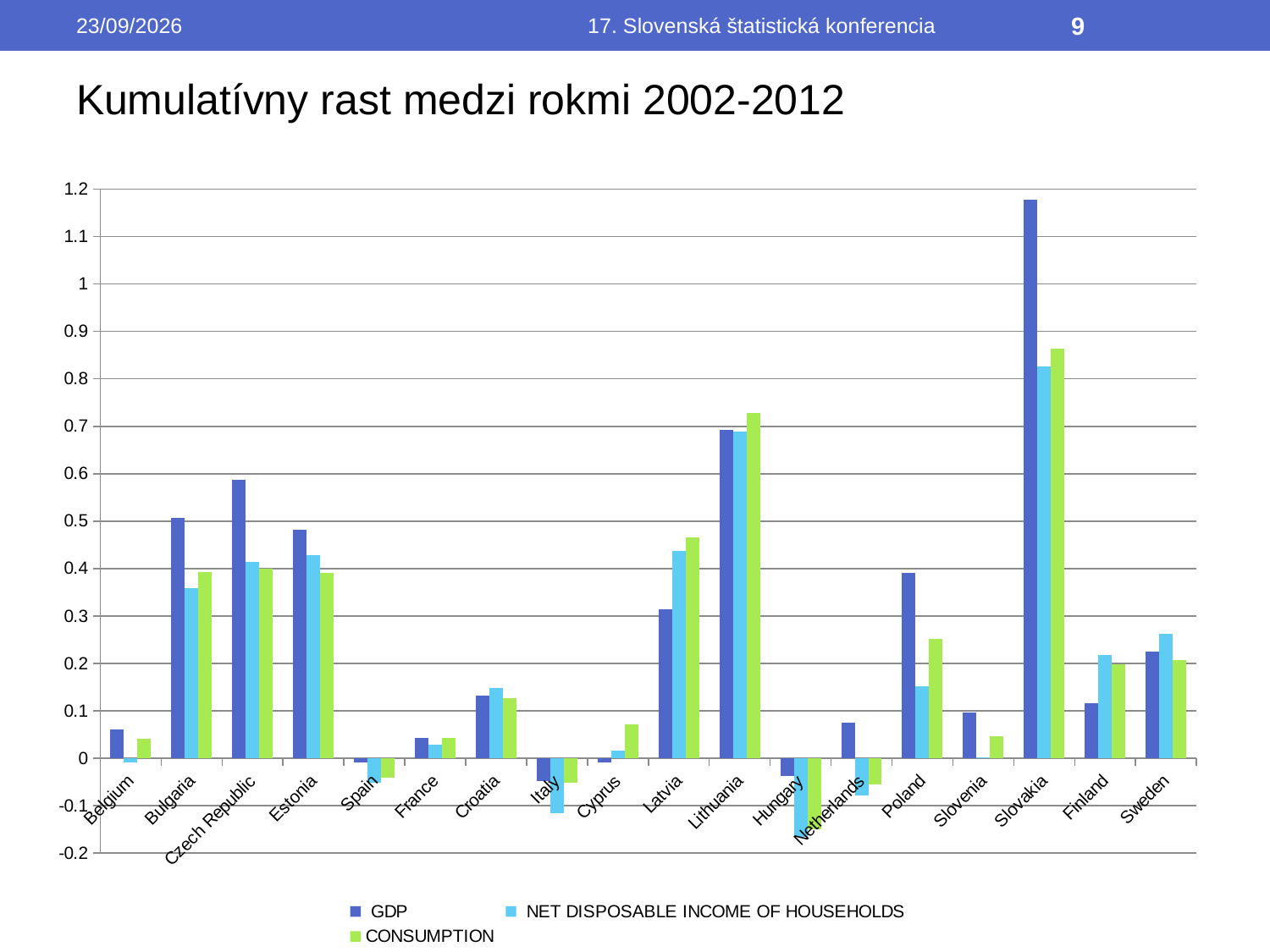
Is the GDP value for Czech Republic greater or less than 0.5? greater How many countries are shown on the x axis? 18 Which country has the highest CONSUMPTION value? Slovakia Which country has the lowest NET DISPOSABLE INCOME OF HOUSEHOLDS value? Hungary Which is larger, the CONSUMPTION value for Lithuania or for Latvia? Lithuania How many series does the legend list? 3 What kind of chart is shown on the slide? bar chart Is the GDP value for Slovakia greater or less than 1.1? greater What is the title of the chart? Kumulatívny rast medzi rokmi 2002-2012 Which is larger, the GDP value for Czech Republic or for Estonia? Czech Republic Which country has the highest GDP value? Slovakia Is the NET DISPOSABLE INCOME OF HOUSEHOLDS value for Hungary greater or less than -0.1? less